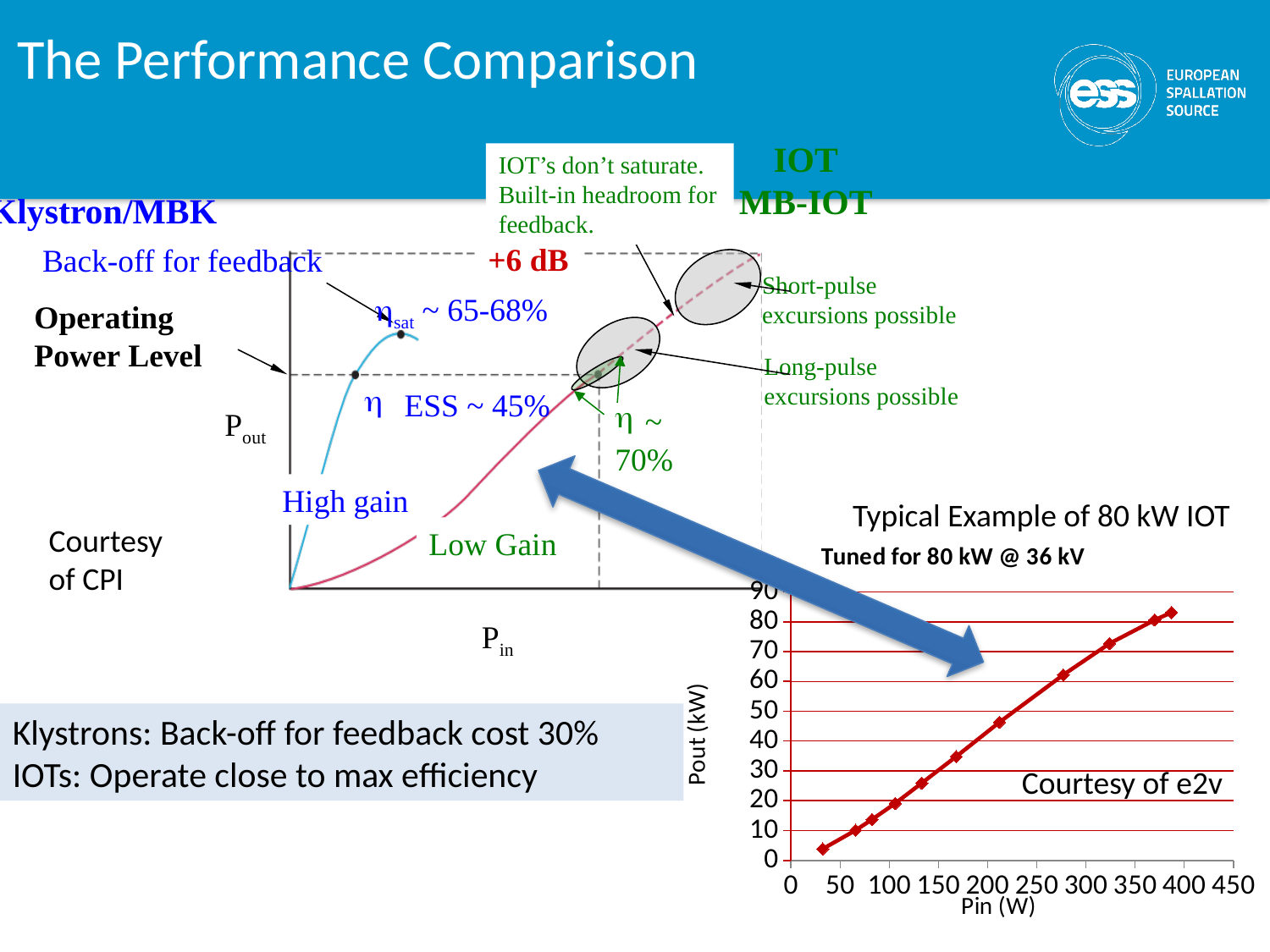
What kind of chart is the 'Tuned for 80 kW @ 36 kV' chart at the bottom right of the slide? line chart In the 'Tuned for 80 kW @ 36 kV' chart, is the Pout value at Pin = 100 W greater or less than 30? less In the 'Tuned for 80 kW @ 36 kV' chart, does Pout rise or fall as Pin increases? rises What is the y-axis label of the 'Tuned for 80 kW @ 36 kV' chart? Pout (kW) What is the highest tick value shown on the x-axis of the 'Tuned for 80 kW @ 36 kV' chart? 450 In the 'Tuned for 80 kW @ 36 kV' chart, is the Pout value at the lowest plotted Pin greater or less than 10? less How many data series are plotted in the 'Tuned for 80 kW @ 36 kV' chart? 1 In the 'Tuned for 80 kW @ 36 kV' chart, is the Pout value at Pin = 200 W greater or less than 60? less